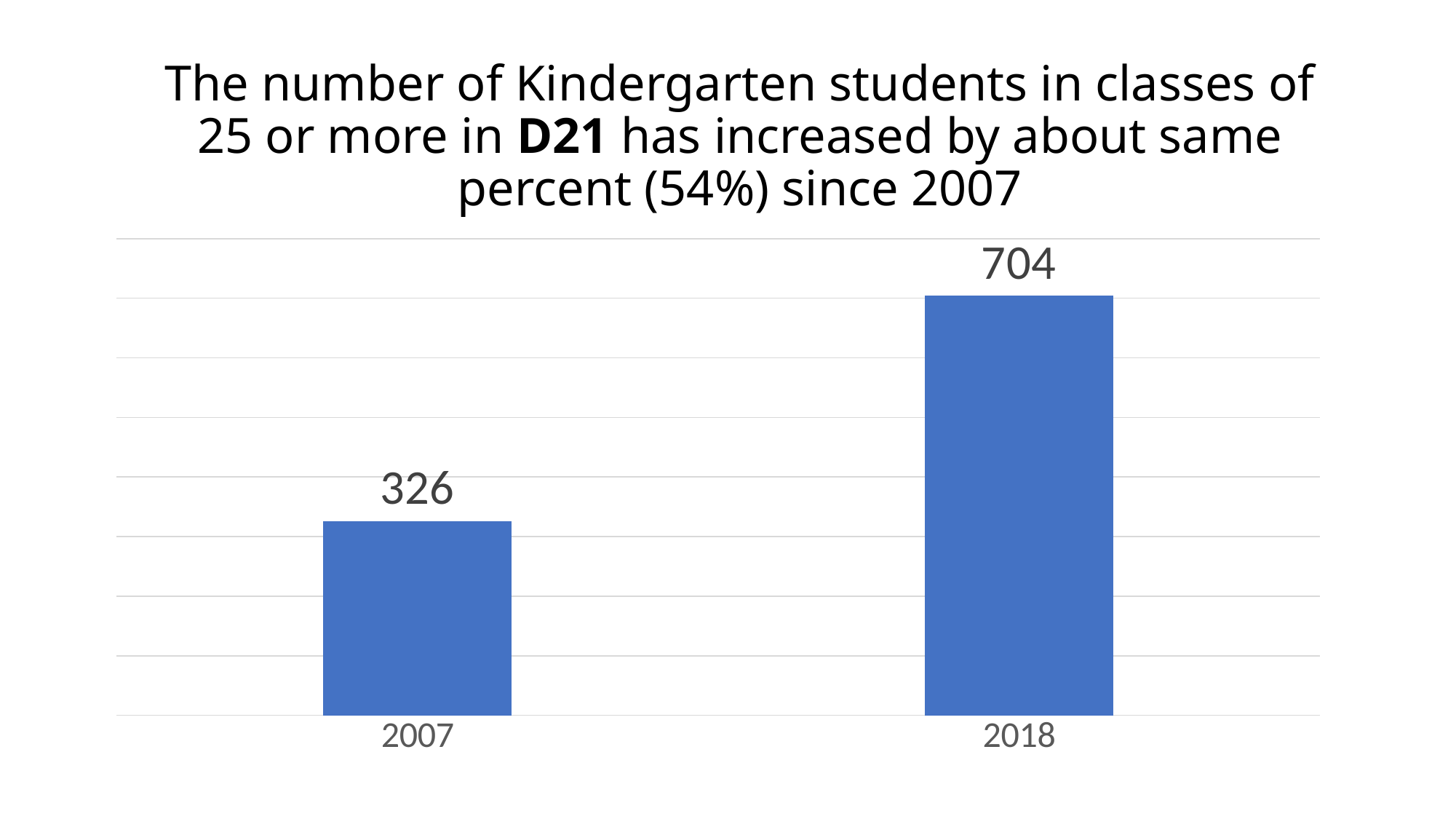
What colour are the bars in the chart? blue Which year has the highest value? 2018 What kind of chart is shown on the slide? bar chart Which year has the lowest value? 2007 What is the value for 2018? 704 What percentage increase since 2007 does the chart title state? 54% Which is larger, the value for 2007 or the value for 2018? 2018 Do the values rise or fall from 2007 to 2018? rise What is the difference between the values for 2018 and 2007? 378 How many bars are shown in the chart? 2 What is the value for 2007? 326 What is the total of the two bars combined? 1030